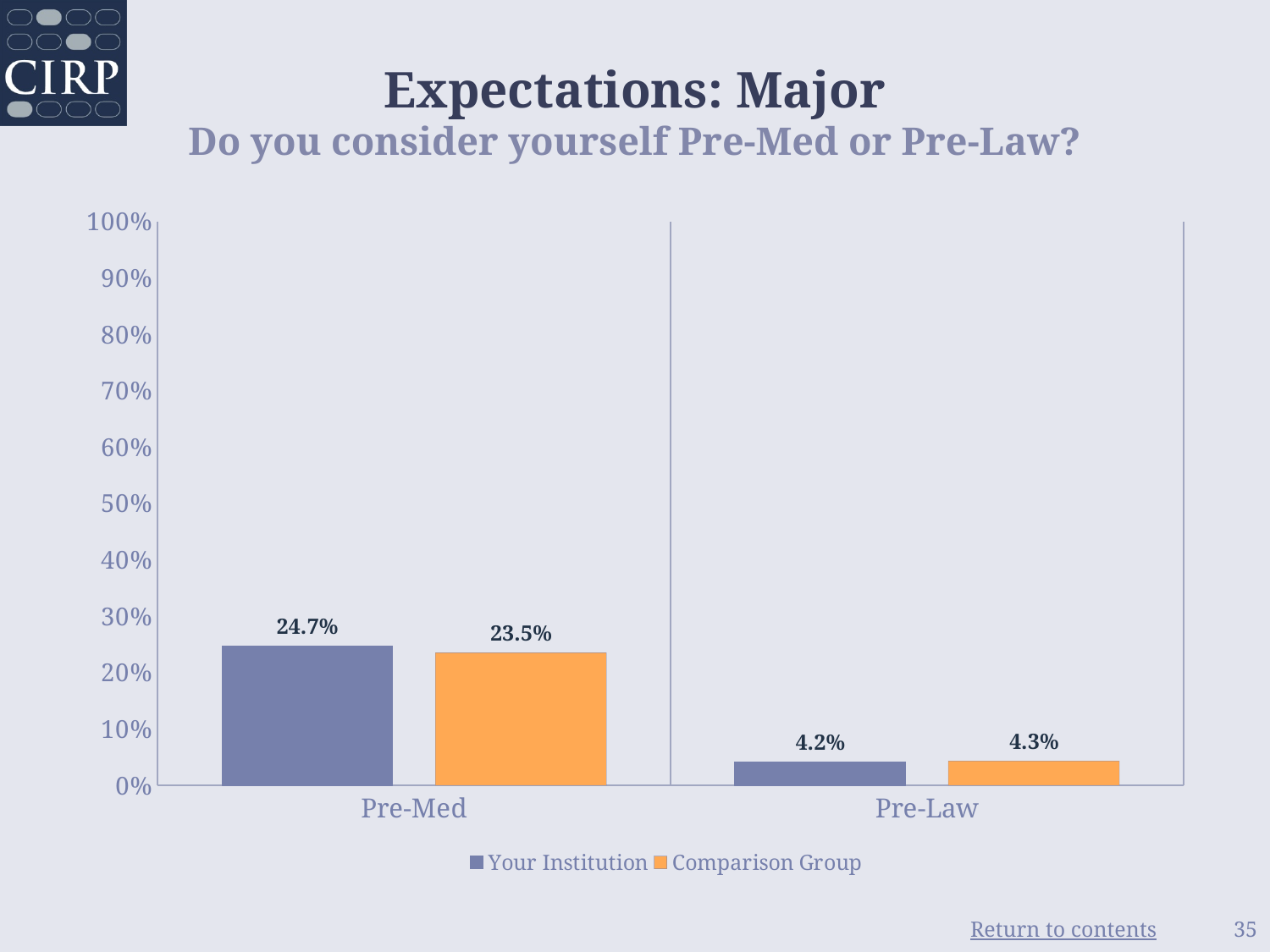
Is the Your Institution value for Pre-Med greater or less than 20%? greater What kind of chart is shown on the slide? Bar chart How many categories are shown on the x axis? 2 How many series does the legend list? 2 What is the Comparison Group value for Pre-Law? 4.3% What is the Comparison Group value for Pre-Med? 23.5% For Pre-Med, which is larger: Your Institution or Comparison Group? Your Institution Which category has the lowest value for the Comparison Group? Pre-Law What is the Your Institution value for Pre-Law? 4.2% What is the difference between the Your Institution and Comparison Group values for Pre-Med? 1.2% What percentage of Your Institution students consider themselves Pre-Med? 24.7% Which category has the highest value for Your Institution? Pre-Med